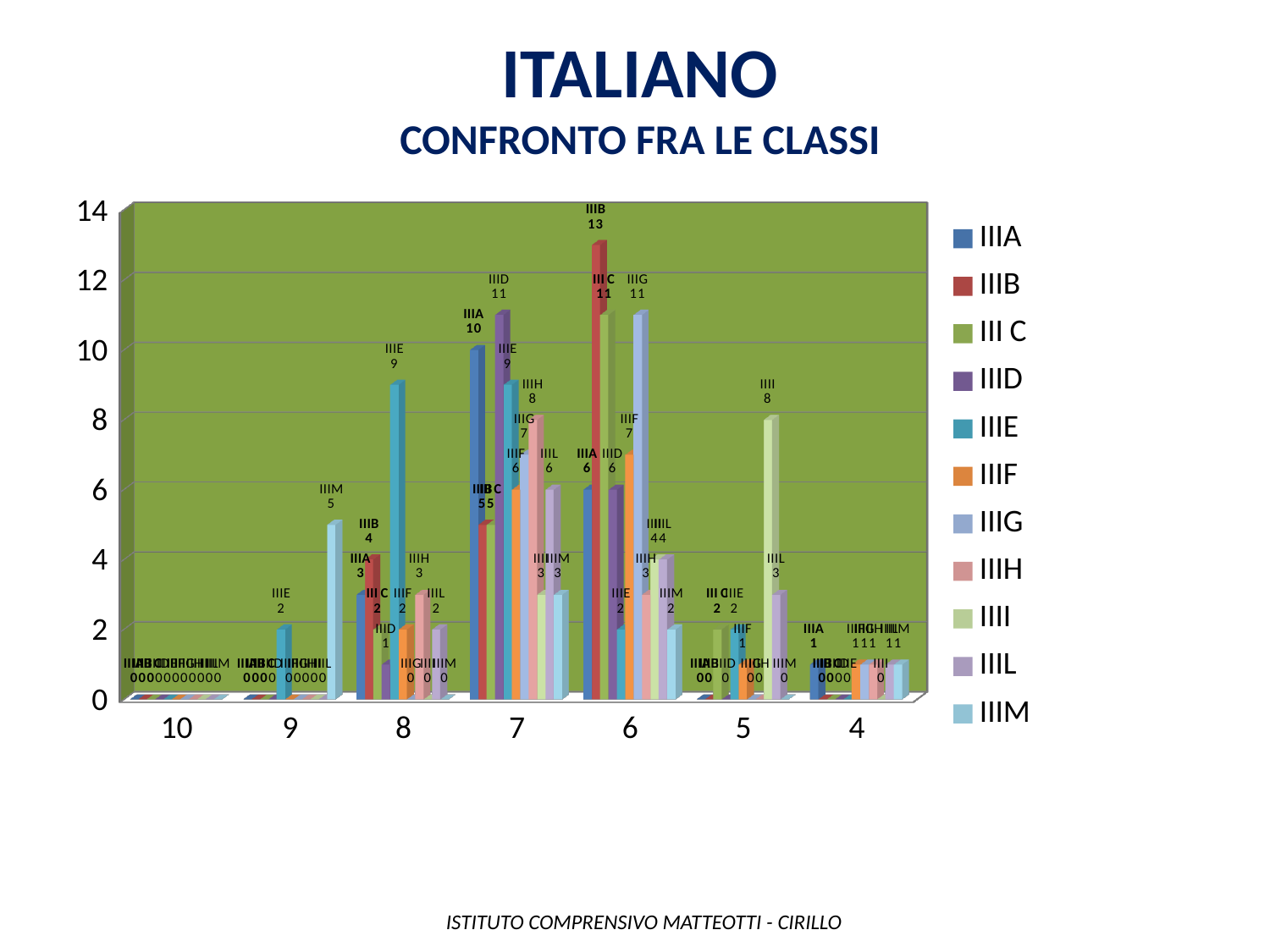
What is the value for IIIM at category 9? 5 What is the value for IIIB at category 6? 13 Which is larger: the value for IIIE at category 8 or the value for IIIE at category 6? IIIE at category 8 What is the value for IIIE at category 8? 9 What kind of chart is shown on the slide? bar chart How many categories are shown on the x axis? 7 What is the value for IIII at category 5? 8 How many series does the legend list? 11 Which series has the tallest bar in the whole chart, and at which category? IIIB at 6 What is the difference between the value for IIIB at category 6 and the value for IIIA at category 7? 3 What is the value for IIIA at category 7? 10 What is the subtitle of the chart shown below the title ITALIANO? CONFRONTO FRA LE CLASSI